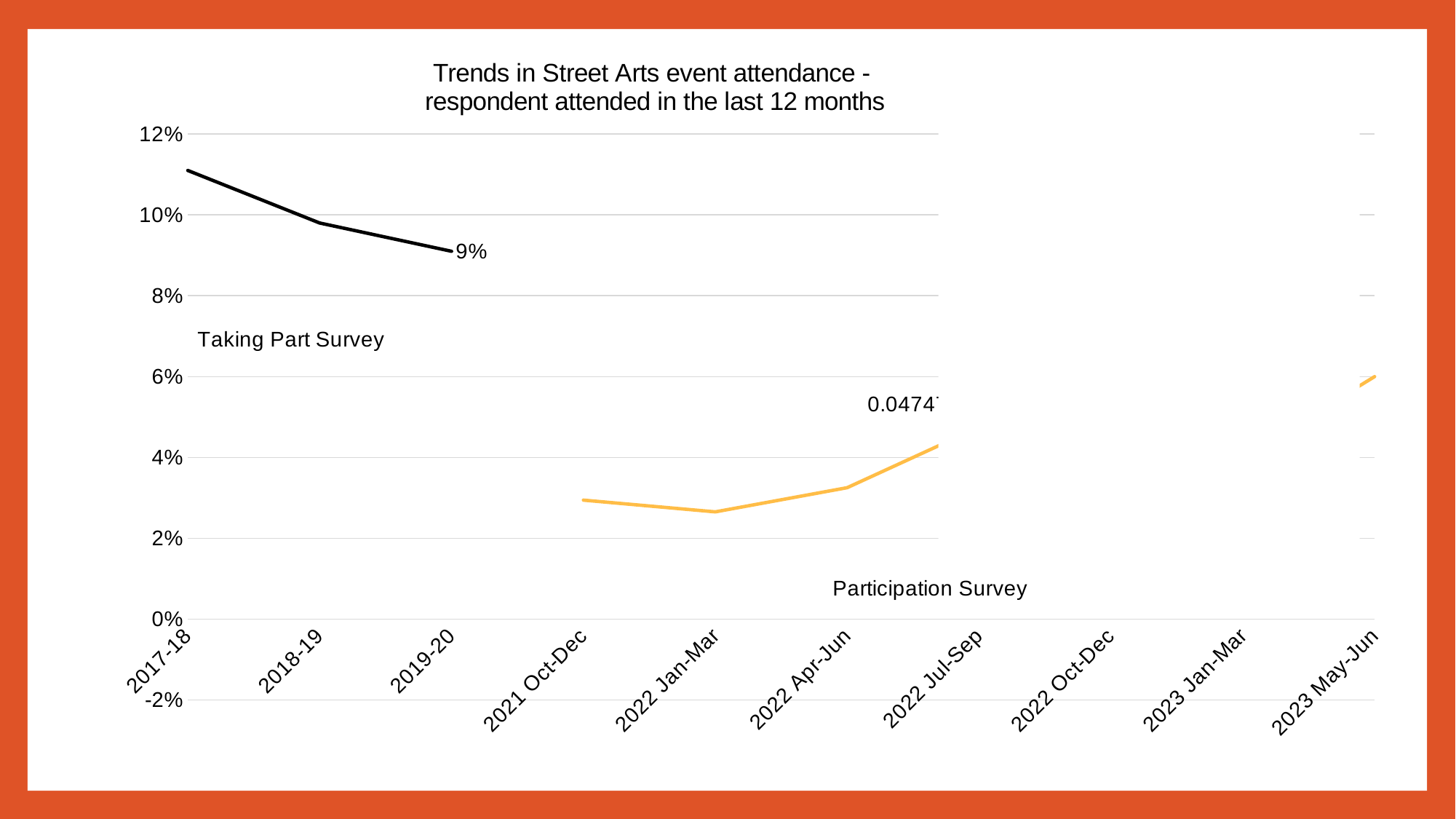
Which is larger: the Taking Part Survey value for 2017-18 or the Participation Survey value for 2021 Oct-Dec? 2017-18 What is the Taking Part Survey value for 2019-20? 9% Is the Participation Survey value for 2021 Oct-Dec greater or less than 2%? greater What kind of chart is shown on the slide? line chart Is the Participation Survey value for 2022 Jan-Mar greater or less than 4%? less Does the Taking Part Survey line rise or fall from 2017-18 to 2019-20? fall Which category has the lowest Participation Survey value among 2021 Oct-Dec, 2022 Jan-Mar, 2022 Apr-Jun and 2022 Jul-Sep? 2022 Jan-Mar How many categories are labelled along the x axis? 10 Is the Taking Part Survey value for 2017-18 greater or less than 10%? greater What are the names of the two series shown on the chart? Taking Part Survey and Participation Survey What is the title of the chart? Trends in Street Arts event attendance - respondent attended in the last 12 months Does the Participation Survey line rise or fall from 2022 Jan-Mar to 2022 Jul-Sep? rise